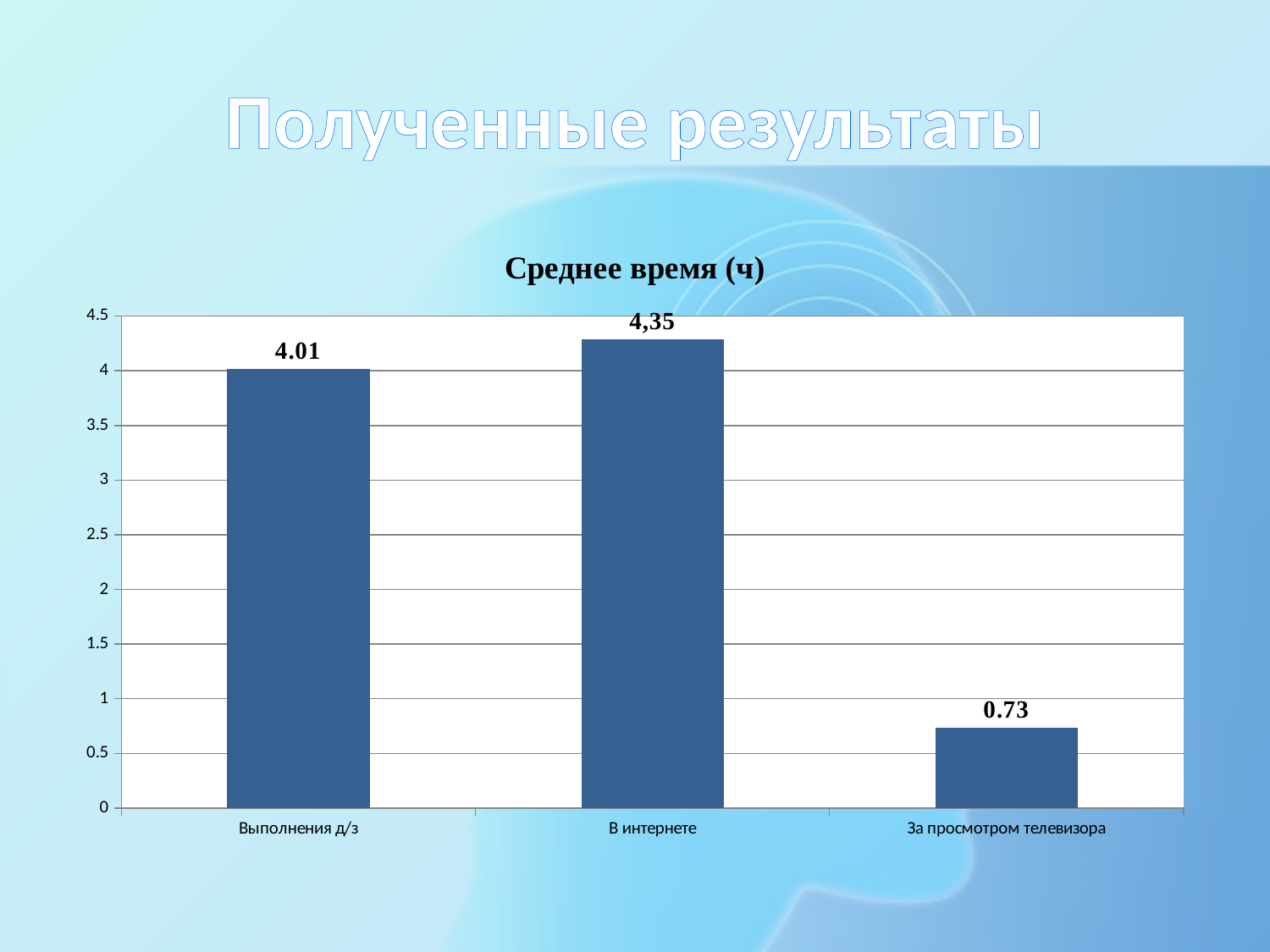
Is the value for «За просмотром телевизора» greater or less than 1? less How many categories are shown in the chart? 3 What is the value for «В интернете»? 4,35 Which category has the lowest value? За просмотром телевизора What is the title of the chart? Среднее время (ч) What is the value for «Выполнения д/з»? 4.01 Which is larger, the value for «Выполнения д/з» or the value for «За просмотром телевизора»? Выполнения д/з Which category has the highest value? В интернете What is the difference between the values for «Выполнения д/з» and «За просмотром телевизора»? 3.28 What kind of chart is shown on the slide? bar chart What is the value for «За просмотром телевизора»? 0.73